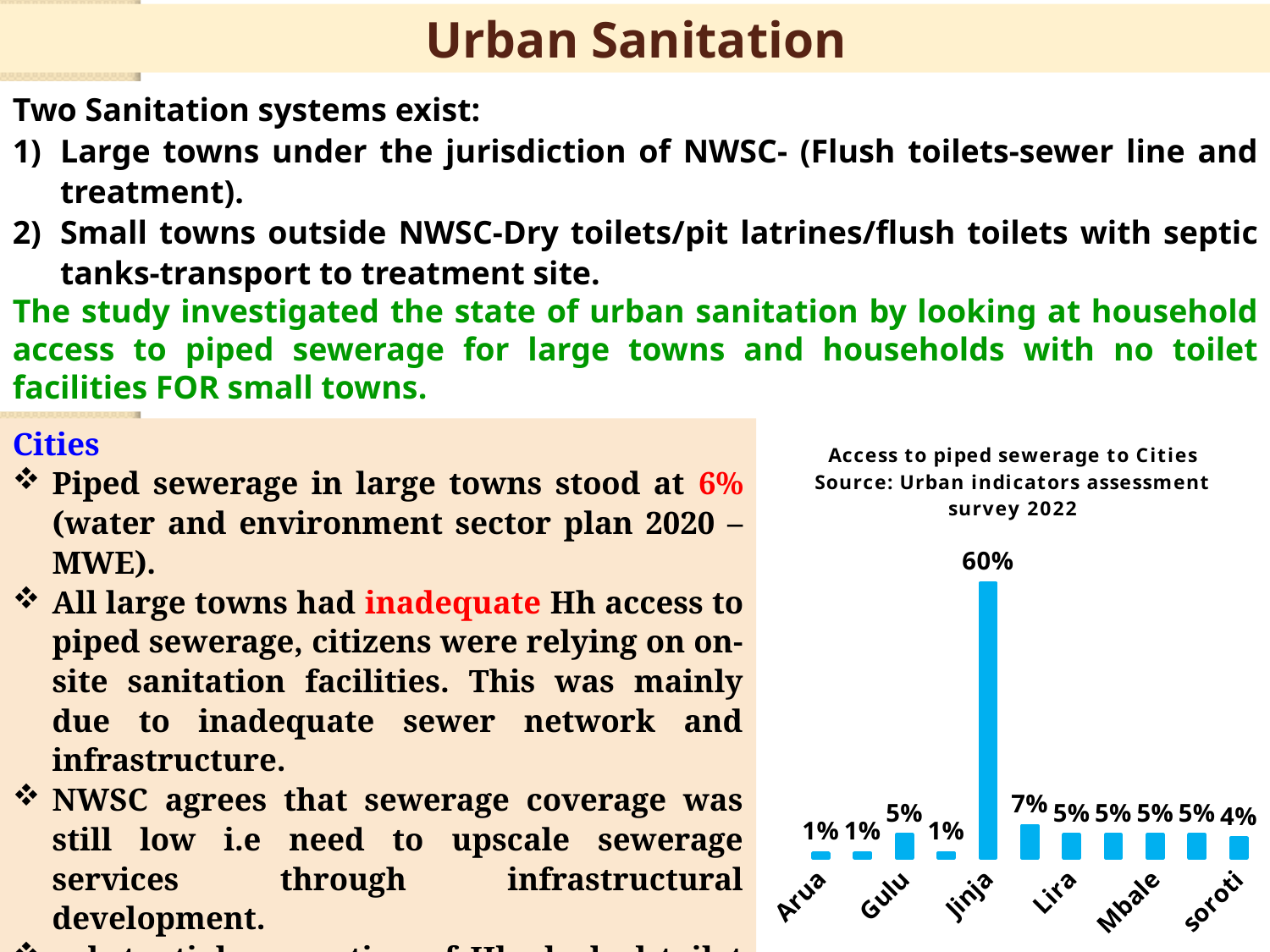
Which is larger in the chart, the value for Lira or the value for Mbale? Neither; they are equal (both 5%) What is the value for Gulu in the 'Access to piped sewerage to Cities' chart? 5% Which city has the highest access to piped sewerage in the chart? Jinja What is the difference between the values for Jinja and Lira in the chart? 55% What is the value for Lira in the 'Access to piped sewerage to Cities' chart? 5% What is the difference between the values for Lira and soroti in the chart? 1% What is the value for soroti in the 'Access to piped sewerage to Cities' chart? 4% What is the value for Arua in the 'Access to piped sewerage to Cities' chart? 1% What kind of chart is shown on the slide? Bar chart What is the value for Mbale in the 'Access to piped sewerage to Cities' chart? 5% How many bars are plotted in the 'Access to piped sewerage to Cities' chart? 11 What is the value for Jinja in the 'Access to piped sewerage to Cities' chart? 60%